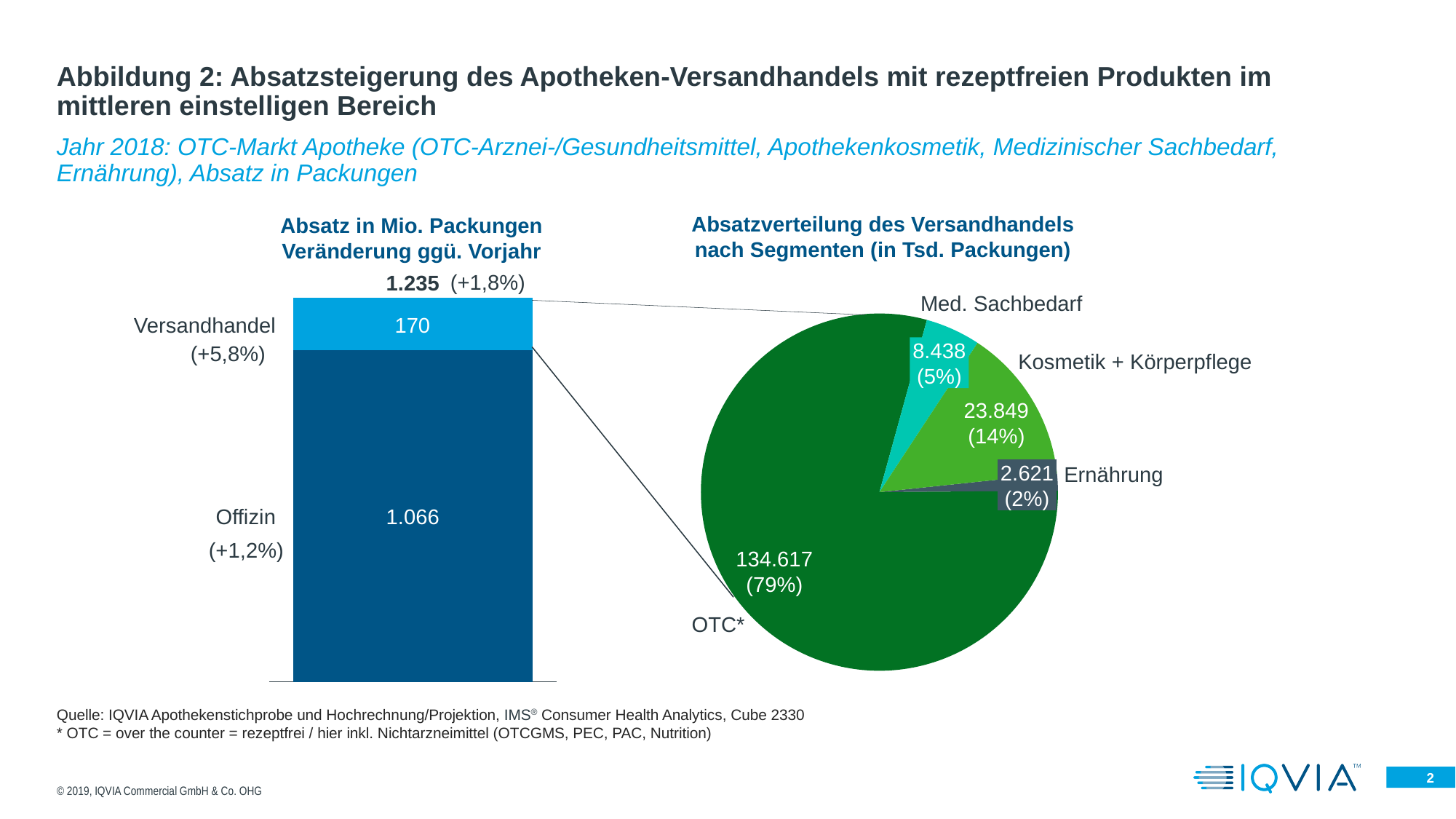
In the pie chart on the right, what share does OTC* have? 79% In the pie chart on the right, how many segments are shown? 4 In the stacked bar chart on the left, which segment is larger, Offizin or Versandhandel? Offizin In the stacked bar chart on the left, what is the total of the stacked bar? 1.235 In the pie chart on the right, which segment is the smallest? Ernährung In the stacked bar chart on the left, what is the year-on-year change shown for Versandhandel? +5,8% In the stacked bar chart on the left, what is the difference between the Offizin and Versandhandel values? 896 In the stacked bar chart on the left, what is the value for Versandhandel? 170 In the pie chart on the right, which segment is the largest? OTC* In the stacked bar chart on the left, what is the value for Offizin? 1.066 In the pie chart on the right, what is the value for Kosmetik + Körperpflege? 23.849 What type of chart is shown on the right side of the slide? Pie chart